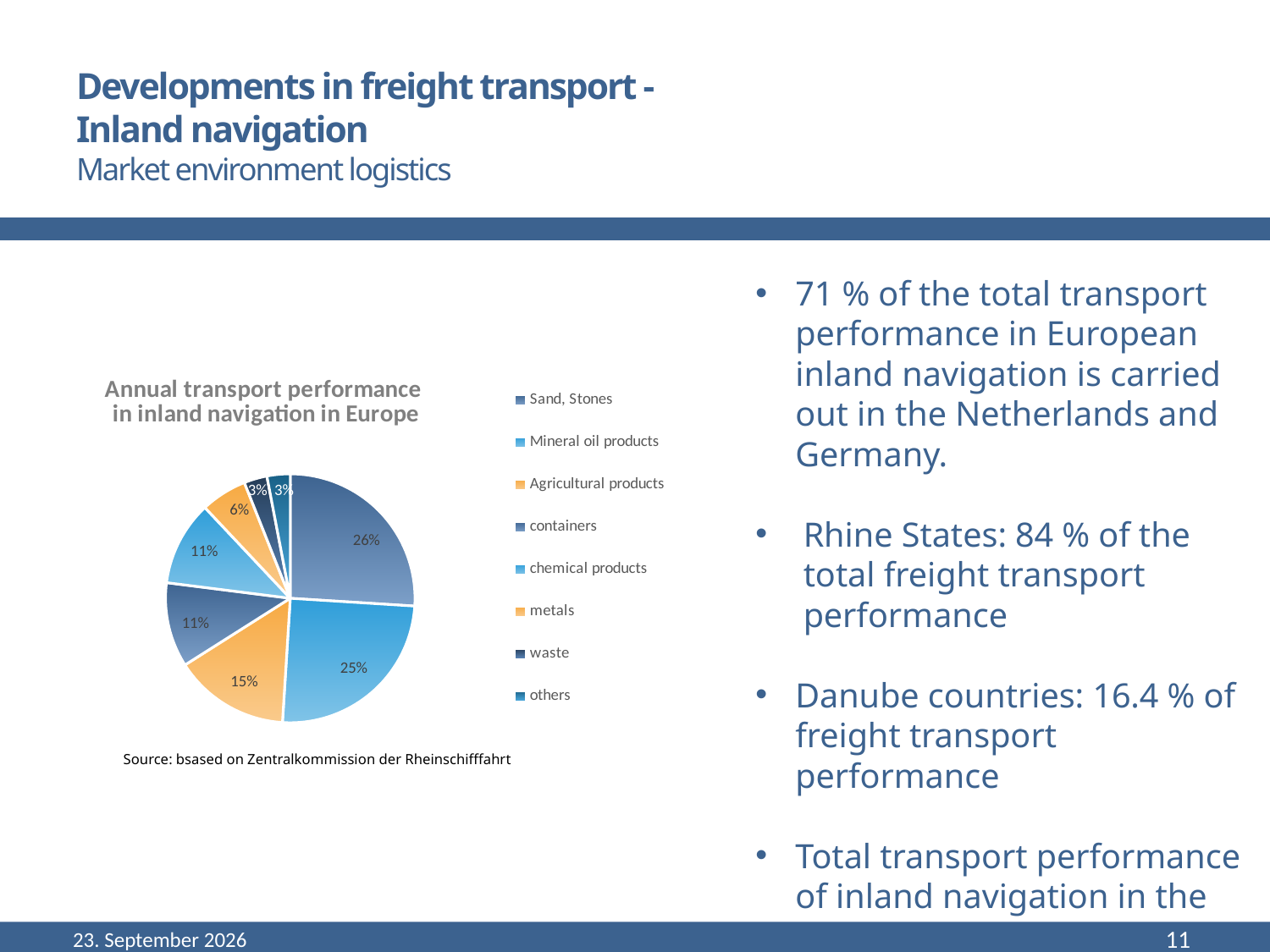
What is the difference in percentage points between Sand, Stones and Agricultural products? 11 What share of the pie does Sand, Stones account for? 26% What is the combined share of waste and others? 6% What type of chart is shown on the slide? pie chart Which is larger, the share for Mineral oil products or the share for containers? Mineral oil products How many categories does the legend list? 8 What is the title of the chart? Annual transport performance in inland navigation in Europe What is the value shown for Agricultural products? 15% What is the value shown for Mineral oil products? 25% What is the value shown for metals? 6% Which category has the largest slice of the pie? Sand, Stones How many slices does the pie chart have? 8